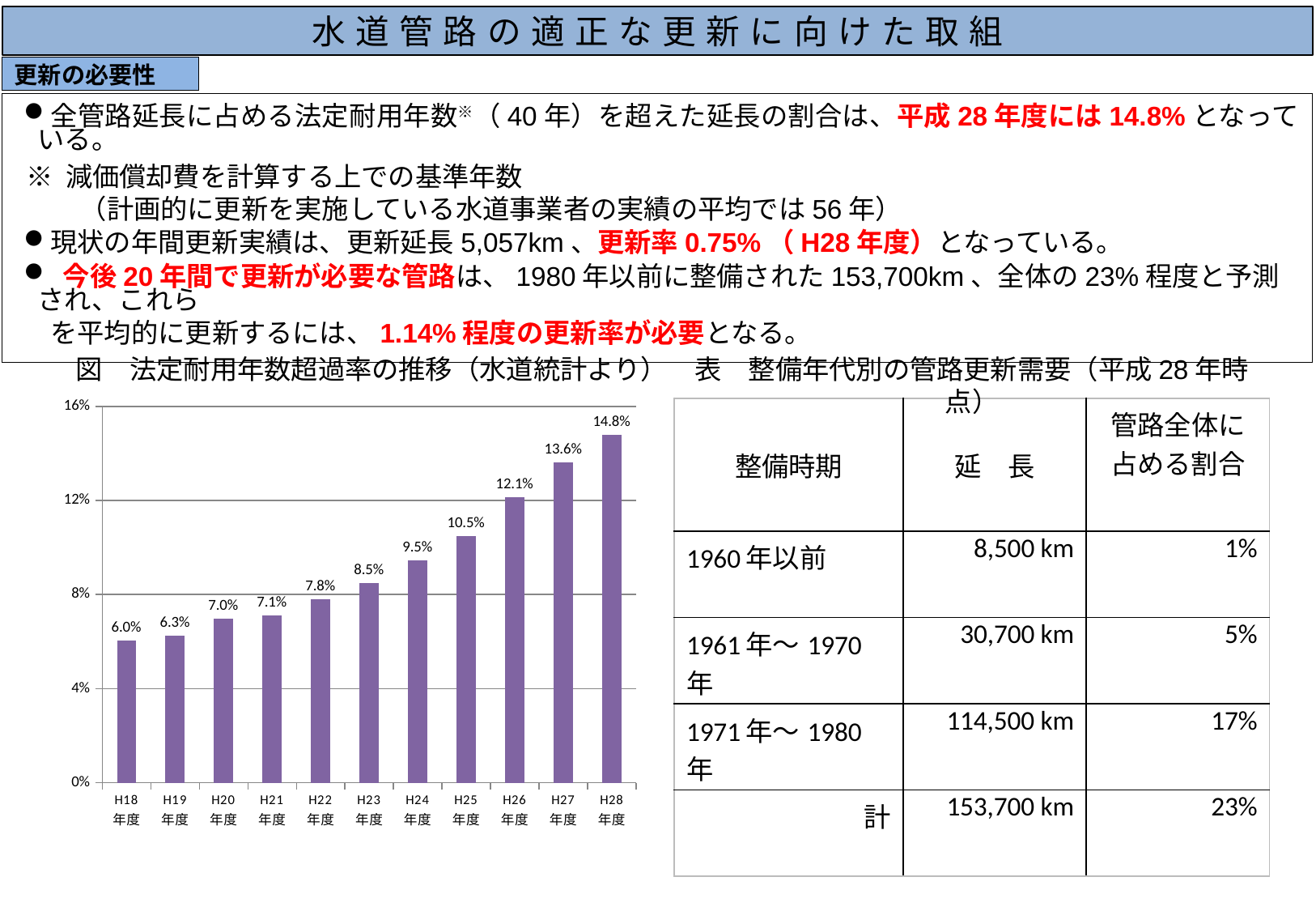
What is the value for H28年度 in the bar chart? 14.8% Is the value for H25年度 in the bar chart greater or less than 12%? less What is the difference between the values for H27年度 and H26年度 in the bar chart? 1.5% Which fiscal year has the lowest value in the bar chart? H18年度 Which fiscal year has the highest value in the bar chart? H28年度 What is the difference between the values for H28年度 and H18年度 in the bar chart? 8.8% What is the value for H24年度 in the bar chart? 9.5% What is the value for H18年度 in the bar chart? 6.0% Which is larger in the bar chart, the value for H22年度 or H23年度? H23年度 Do the values in the bar chart rise or fall from H18年度 to H28年度? rise What kind of chart is shown on the slide? bar chart How many fiscal years are shown in the bar chart? 11